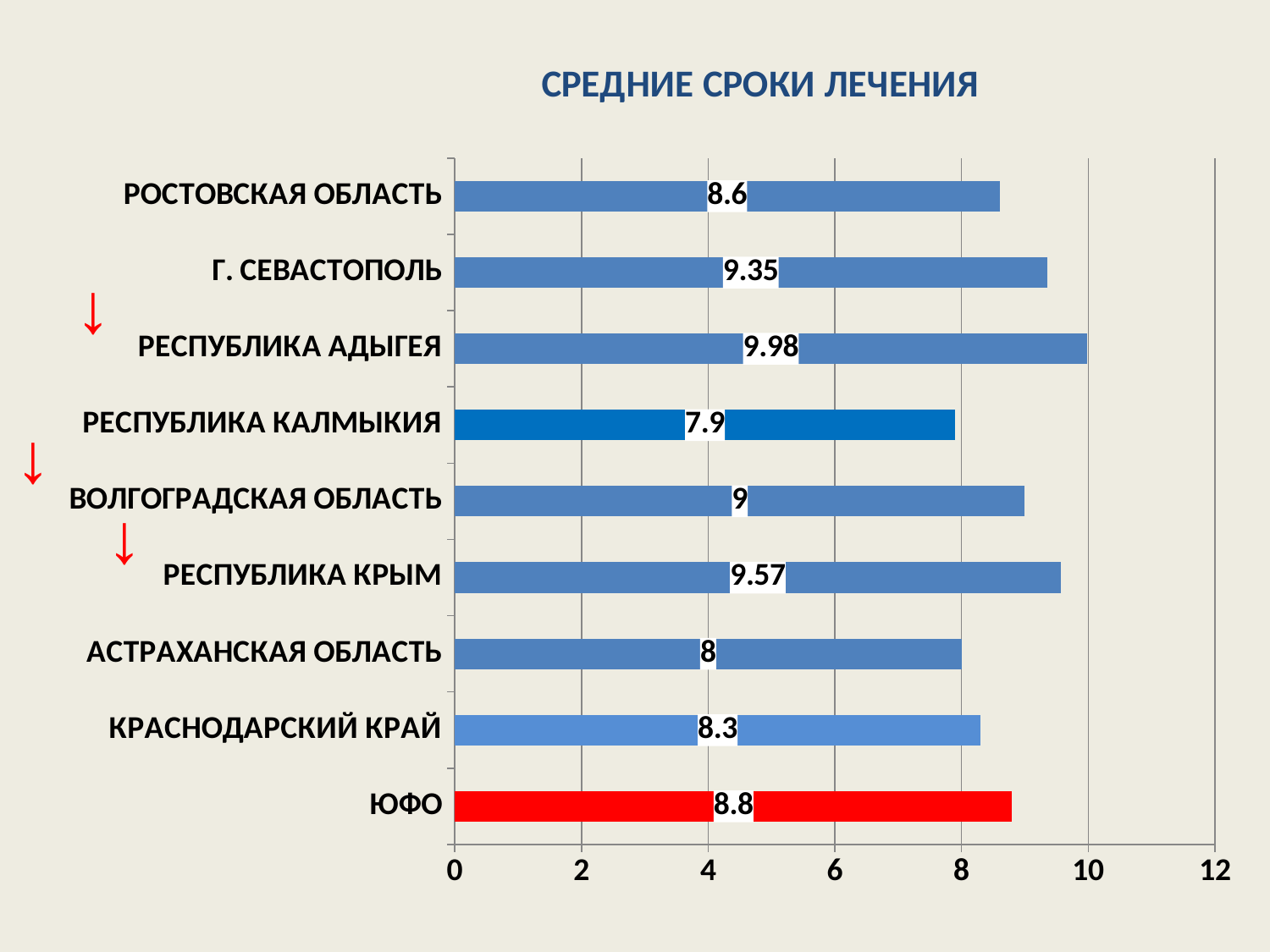
Which is larger, the value for ВОЛГОГРАДСКАЯ ОБЛАСТЬ or the value for КРАСНОДАРСКИЙ КРАЙ? ВОЛГОГРАДСКАЯ ОБЛАСТЬ What is the value for РОСТОВСКАЯ ОБЛАСТЬ? 8.6 Which category has the lowest value? РЕСПУБЛИКА КАЛМЫКИЯ What is the difference between the values for Г. СЕВАСТОПОЛЬ and АСТРАХАНСКАЯ ОБЛАСТЬ? 1.35 What is the value for ЮФО? 8.8 What is the title of the chart? СРЕДНИЕ СРОКИ ЛЕЧЕНИЯ What is the value for РЕСПУБЛИКА КРЫМ? 9.57 How many categories are shown in the chart? 9 Which category has the highest value? РЕСПУБЛИКА АДЫГЕЯ Which category's bar is coloured red? ЮФО Is the value for РЕСПУБЛИКА АДЫГЕЯ greater or less than 8? greater What kind of chart is shown on the slide? bar chart